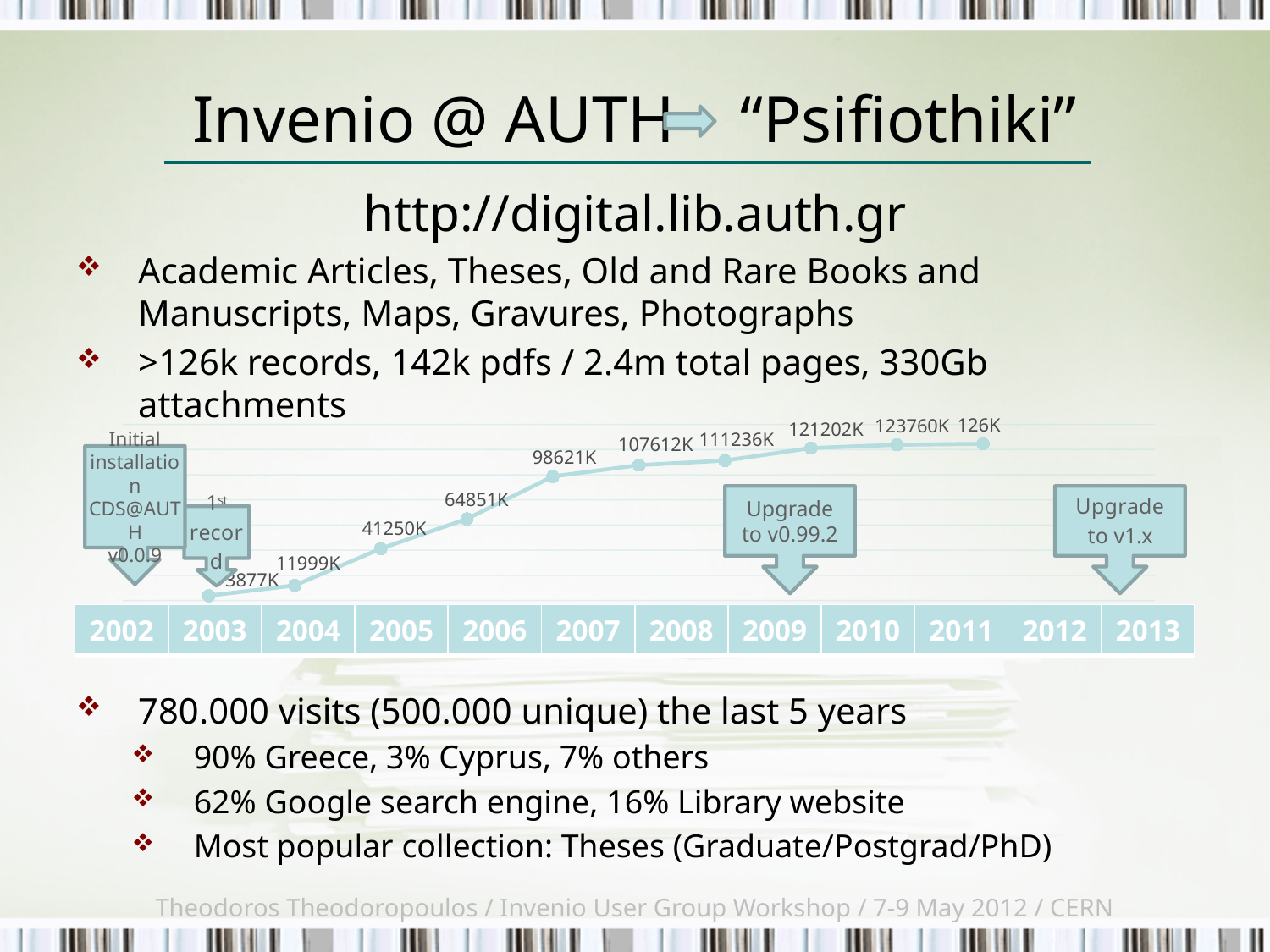
What is the difference between the labelled values for 2004 and 2003? 8122K Do the plotted values rise or fall from 2003 to 2012? rise How many years are listed along the x axis of the chart? 12 What kind of chart is shown on the slide? line chart What value is labelled for 2012 on the chart? 126K What value is labelled for 2010 on the chart? 121202K What value is labelled for 2003 on the chart? 3877K Which is larger, the labelled value for 2006 or for 2008? 2008 Which year has the lowest labelled value on the chart? 2003 What value is labelled for 2005 on the chart? 41250K What is the difference between the labelled values for 2010 and 2009? 9966K What value is labelled for 2007 on the chart? 98621K